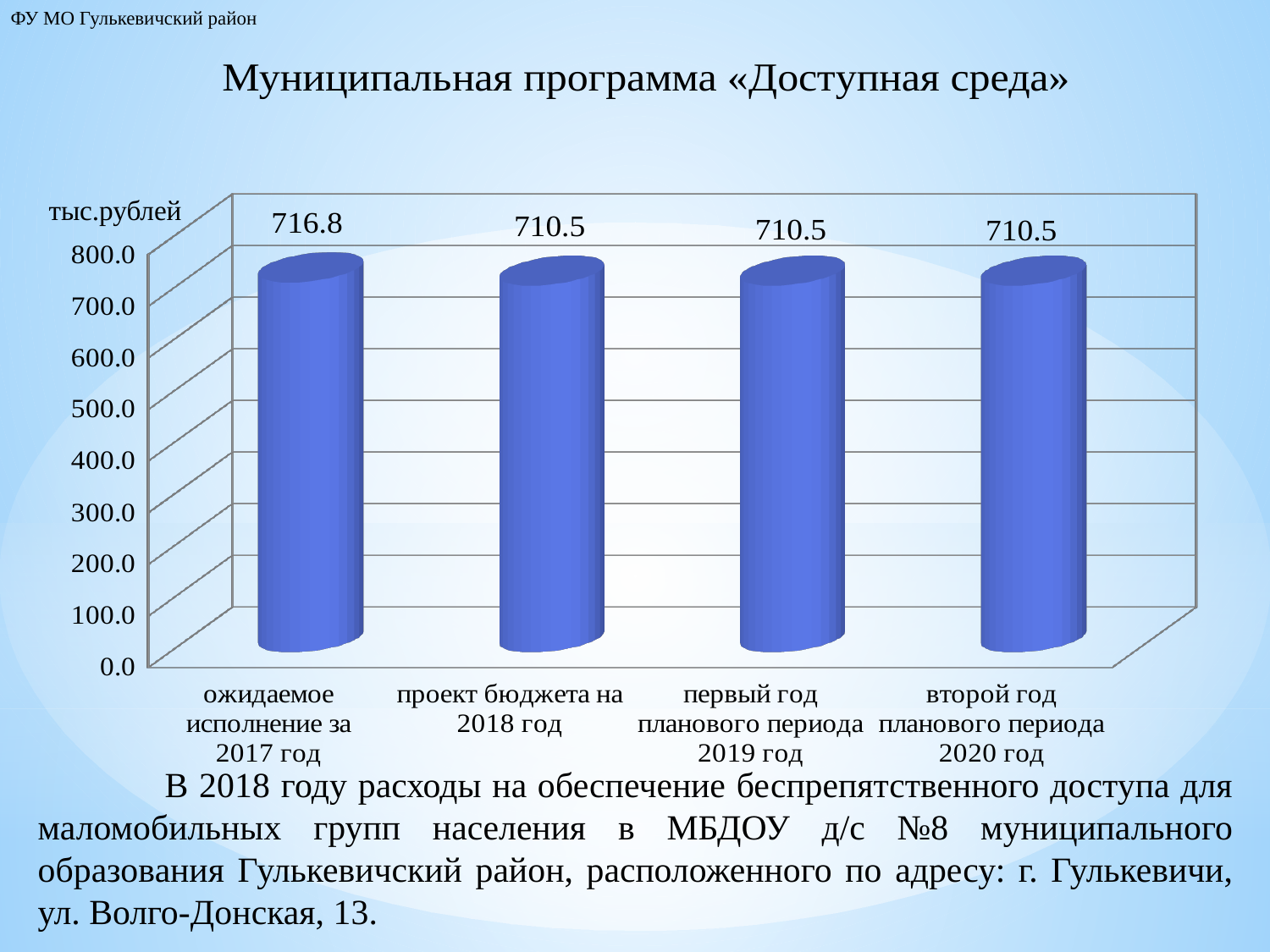
What is the value for 'второй год планового периода 2020 год'? 710.5 Is the value for 'проект бюджета на 2018 год' greater or less than 800.0? less What is the difference between the value for 2017 (ожидаемое исполнение) and the value for 2018 (проект бюджета)? 6.3 How many categories are shown on the chart? 4 What is the value for 'первый год планового периода 2019 год'? 710.5 Which is larger: the value for 'ожидаемое исполнение за 2017 год' or the value for 'проект бюджета на 2018 год'? ожидаемое исполнение за 2017 год Do the values rise or fall from the 2017 category to the 2018 category? fall Which category has the highest value? ожидаемое исполнение за 2017 год What kind of chart is shown on the slide? bar chart What is the value for 'проект бюджета на 2018 год'? 710.5 What is the value for 'ожидаемое исполнение за 2017 год'? 716.8 What unit is indicated on the chart's vertical axis? тыс.рублей